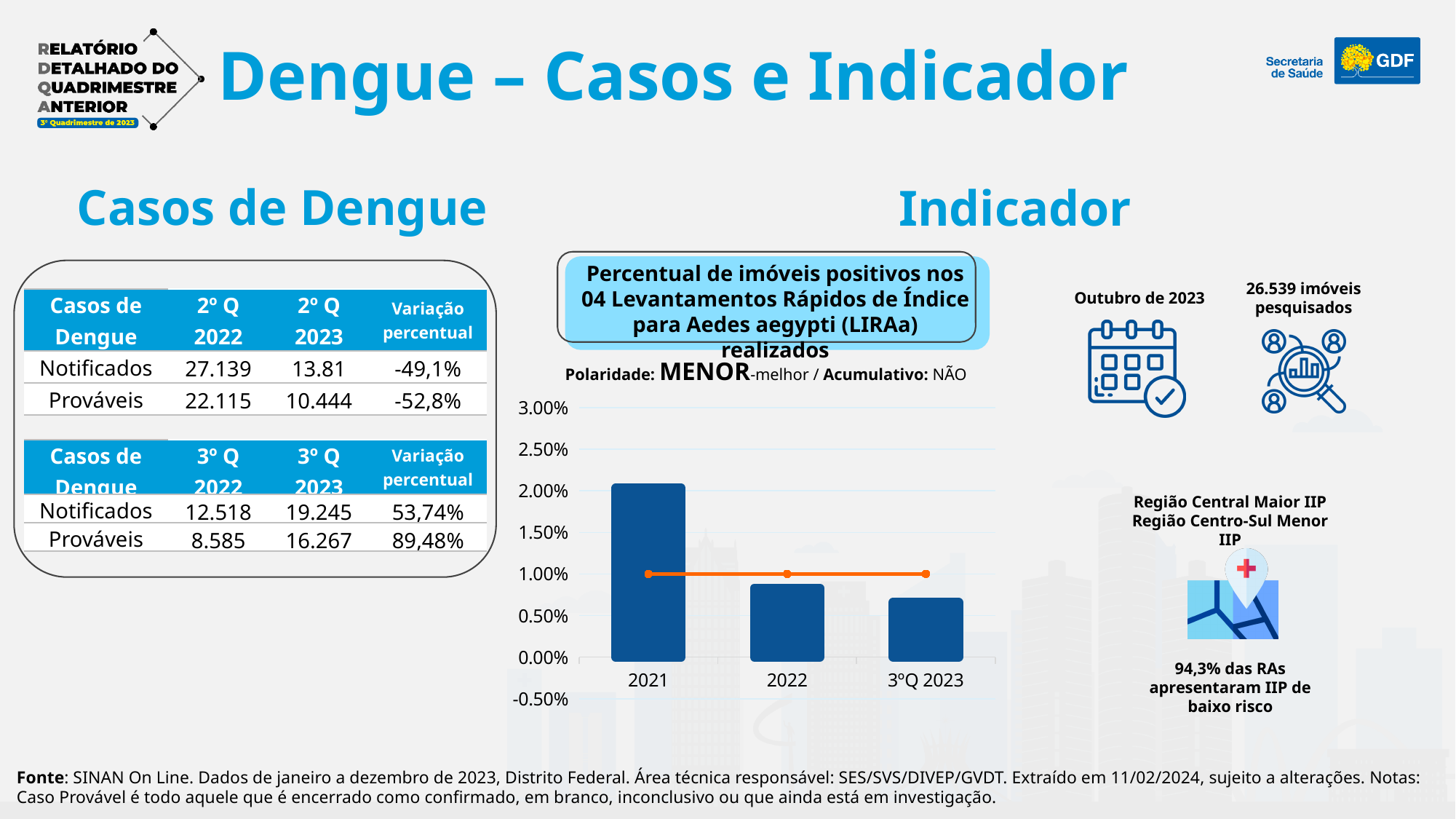
Is the bar value for 2022 greater or less than 1.00%? less Is the bar value for 3ºQ 2023 greater or less than 1.00%? less What kind of chart is used to show the percentage of positive properties in the LIRAa surveys? bar chart Which category has the highest bar in the chart? 2021 How many categories are shown on the x axis of the bar chart? 3 Do the bar values rise or fall from 2021 to 3ºQ 2023? fall Which category has the lowest bar in the chart? 3ºQ 2023 Which bar is taller, 2022 or 3ºQ 2023? 2022 What is the highest value shown on the y axis of the chart? 3.00% What colour are the bars in the chart? dark blue At what value on the y axis does the orange horizontal line sit? 1.00% Is the bar value for 2021 greater or less than 1.50%? greater